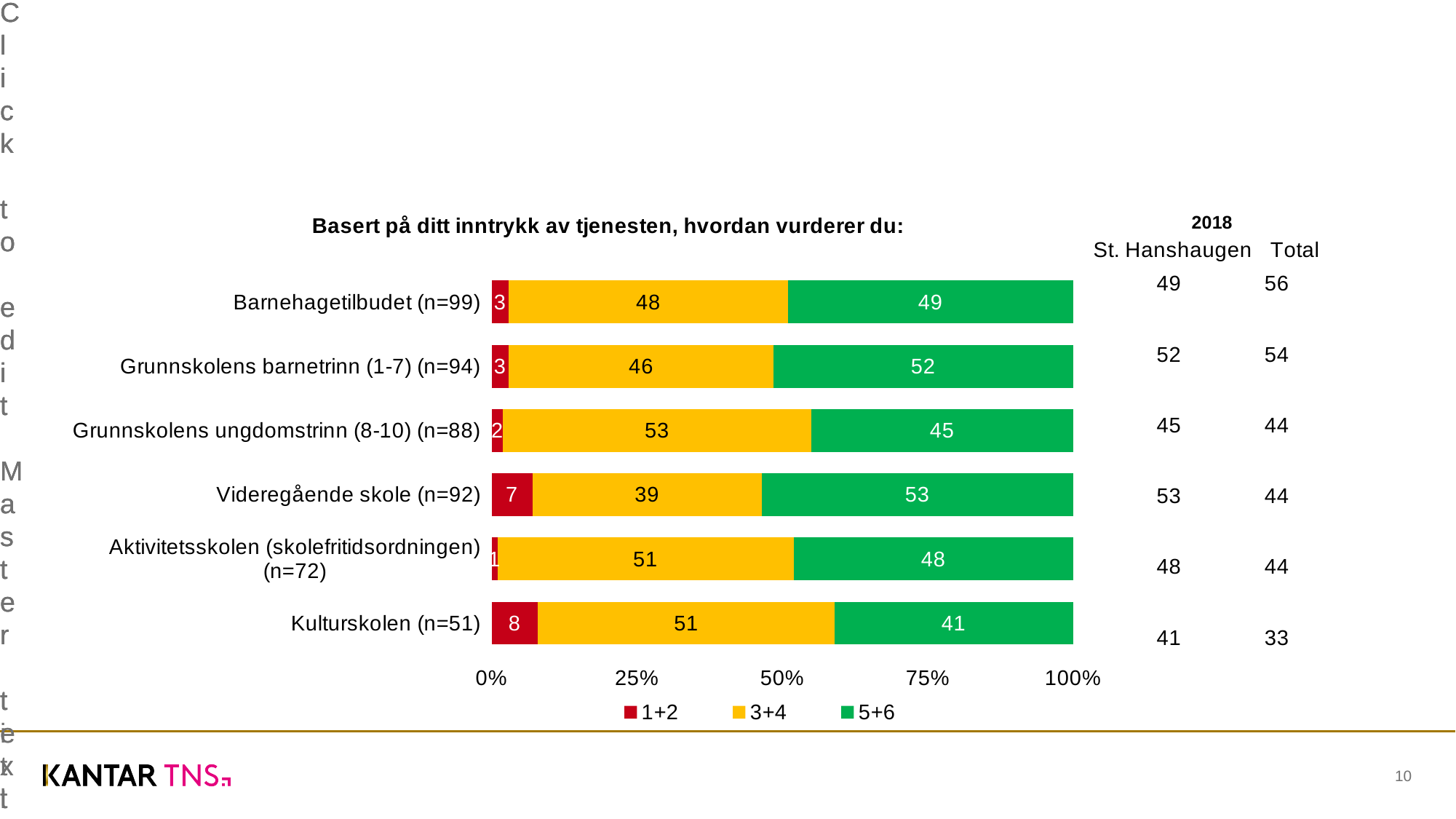
What is the difference between the 5+6 value and the 3+4 value for Videregående skole (n=92)? 14 What is the value of the 1+2 series for Kulturskolen (n=51)? 8 How many categories are shown in the chart? 6 Which category has the highest value for the 1+2 series? Kulturskolen (n=51) Which category has the highest value for the 3+4 series? Grunnskolens ungdomstrinn (8-10) (n=88) What is the value of the 3+4 series for Videregående skole (n=92)? 39 How many series does the legend list? 3 What is the value of the 5+6 series for Barnehagetilbudet (n=99)? 49 Which is larger for Grunnskolens barnetrinn (1-7) (n=94): the 3+4 value or the 5+6 value? 5+6 Which category has the lowest value for the 5+6 series? Kulturskolen (n=51) What kind of chart is shown on the slide? Stacked bar chart What is the title of the chart? Basert på ditt inntrykk av tjenesten, hvordan vurderer du: